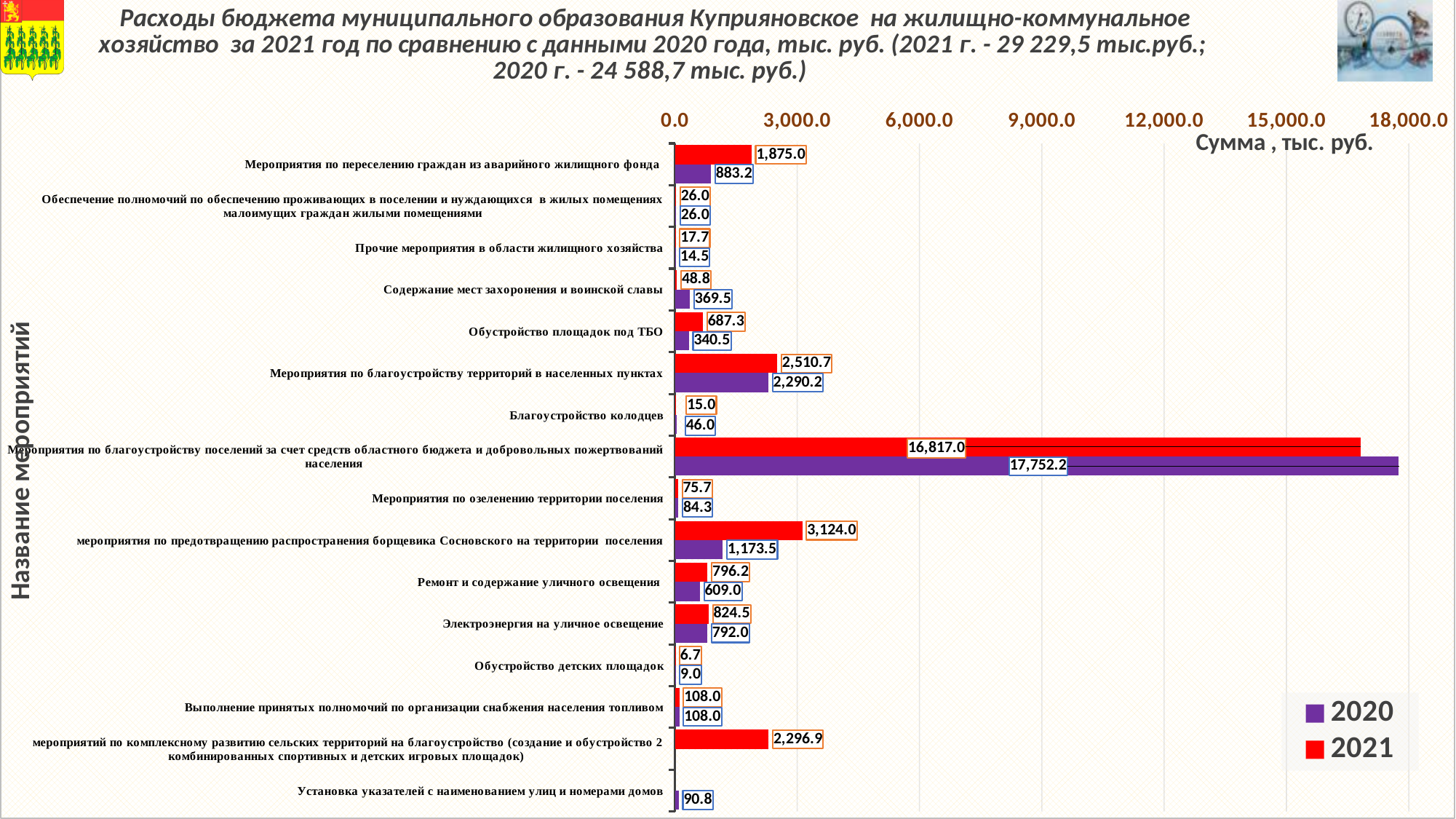
What is the 2021 value for "мероприятий по комплексному развитию сельских территорий на благоустройство"? 2,296.9 Which is larger for "Содержание мест захоронения и воинской славы": the 2020 value or the 2021 value? 2020 What is the difference between the 2021 and 2020 values for "мероприятия по предотвращению распространения борщевика Сосновского на территории поселения"? 1,950.5 What type of chart is shown on the slide? bar chart Which colour represents the 2021 series in the legend? red Which category has the lowest 2021 value? Обустройство детских площадок How many series does the legend list? 2 What is the 2020 value for "Мероприятия по благоустройству поселений за счет средств областного бюджета и добровольных пожертвований населения"? 17,752.2 How many categories (activities) are shown on the chart? 16 Is the 2021 value for "Мероприятия по благоустройству поселений за счет средств областного бюджета и добровольных пожертвований населения" greater or less than 15,000.0? greater Which category has the highest 2021 value? Мероприятия по благоустройству поселений за счет средств областного бюджета и добровольных пожертвований населения What is the 2021 value for "Мероприятия по переселению граждан из аварийного жилищного фонда"? 1,875.0